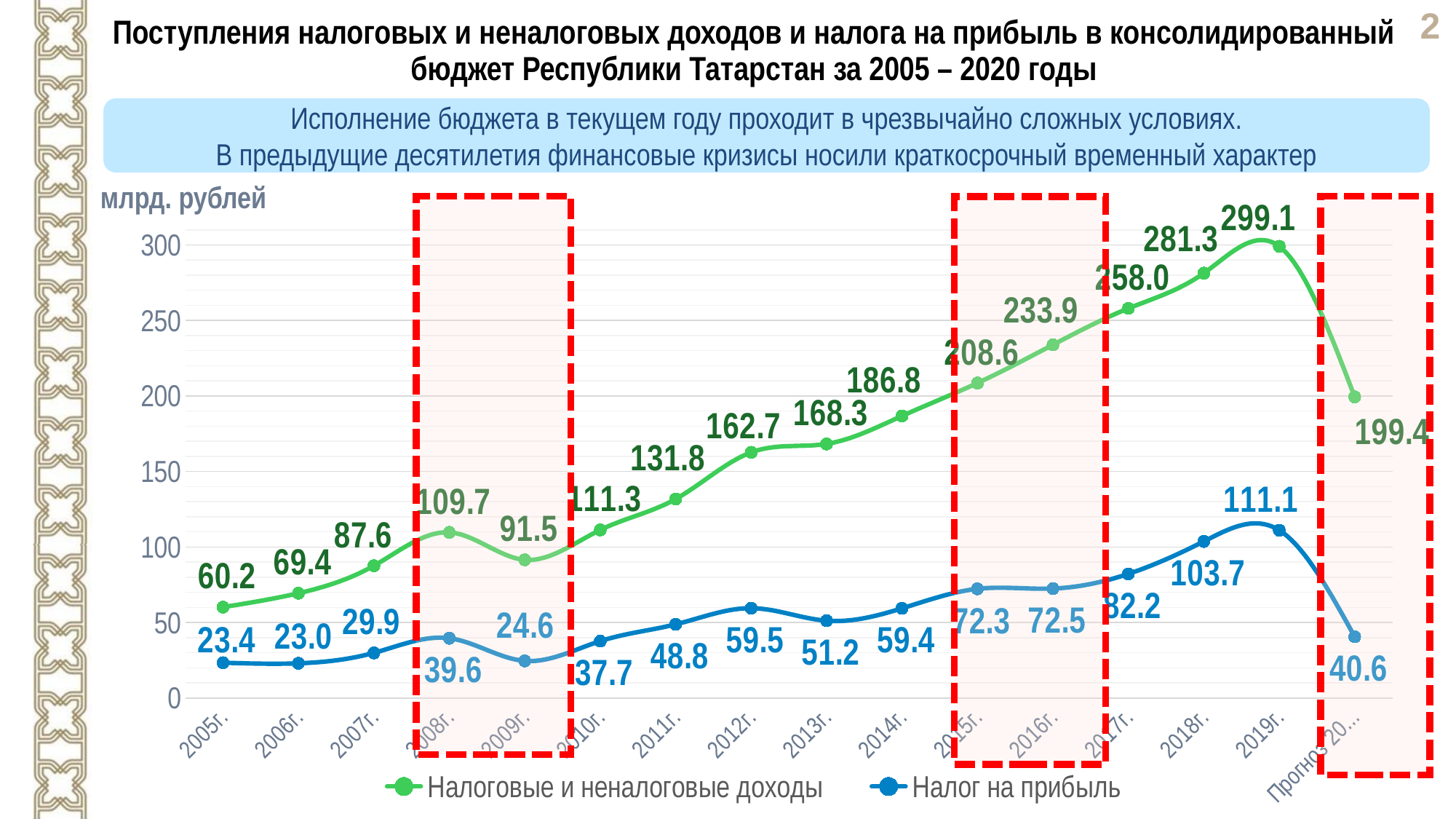
What unit is stated above the chart's vertical axis? млрд. рублей What type of chart is shown on the slide? line chart What is the value of Налоговые и неналоговые доходы for 2009г.? 91.5 How many series does the legend list? 2 Does Налоговые и неналоговые доходы rise or fall from 2010г. to 2019г.? rise How many time points are plotted along the x axis? 16 What is the difference between Налоговые и неналоговые доходы in 2019г. and in 2018г.? 17.8 Which is larger: Налог на прибыль in 2013г. or in 2014г.? 2014г. What is the value of Налоговые и неналоговые доходы for 2019г.? 299.1 In which year does Налог на прибыль reach its highest value? 2019г. What is the value of Налог на прибыль for 2012г.? 59.5 In which year is Налоговые и неналоговые доходы lowest? 2005г.